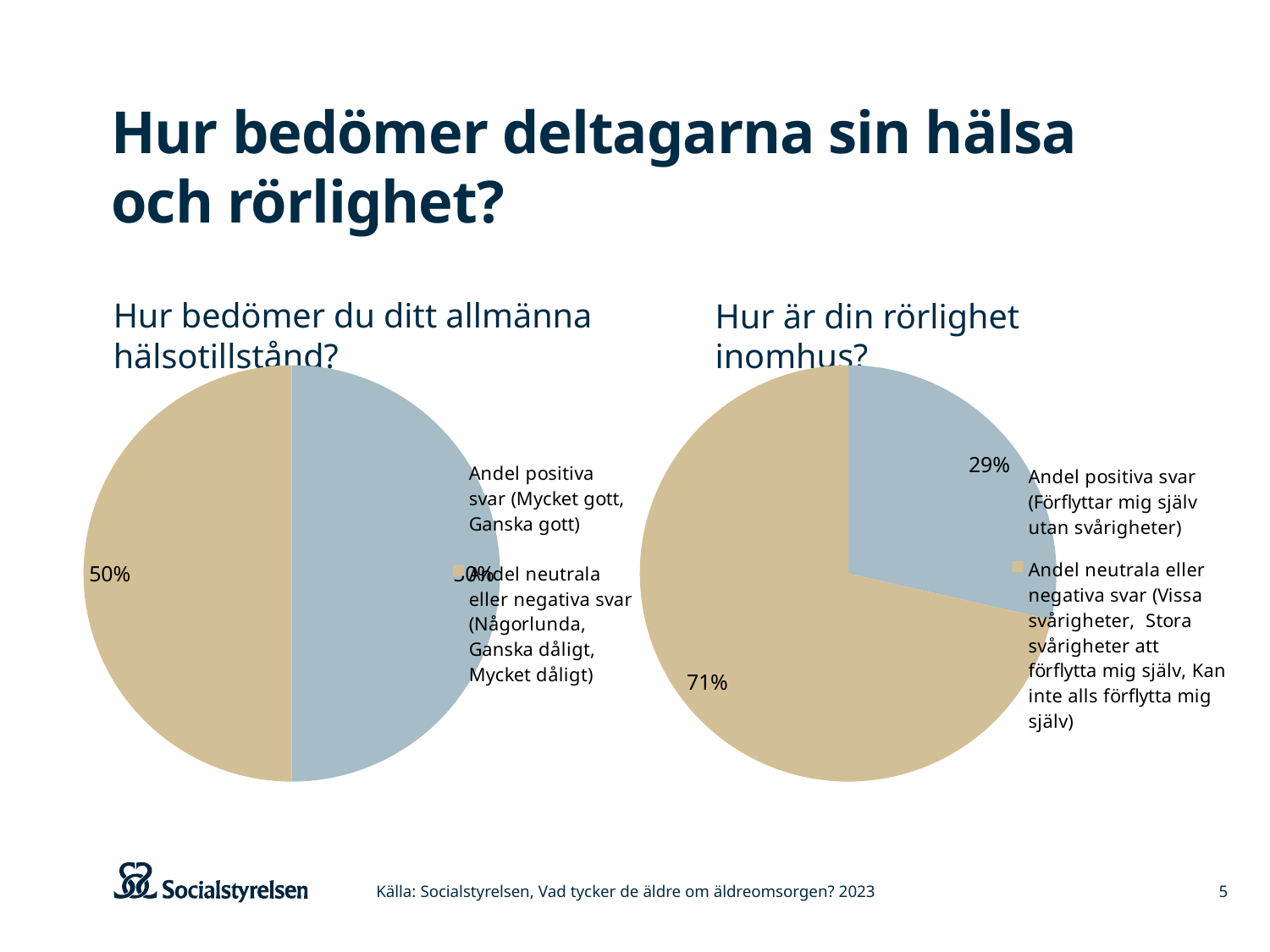
In the chart titled "Hur är din rörlighet inomhus?", which slice is the largest? Andel neutrala eller negativa svar In the chart titled "Hur är din rörlighet inomhus?", what share of the pie is "Andel neutrala eller negativa svar"? 71% What kind of chart is used for "Hur bedömer du ditt allmänna hälsotillstånd?"? pie chart In the chart titled "Hur är din rörlighet inomhus?", what colour is the slice for "Andel positiva svar"? blue-grey In the chart titled "Hur är din rörlighet inomhus?", what is the difference in percentage points between the neutral/negative slice and the positive slice? 42 percentage points In the chart titled "Hur är din rörlighet inomhus?", what share of the pie is "Andel positiva svar (Förflyttar mig själv utan svårigheter)"? 29% How many slices does the pie chart titled "Hur är din rörlighet inomhus?" have? 2 In the chart titled "Hur bedömer du ditt allmänna hälsotillstånd?", what share of the pie is "Andel neutrala eller negativa svar"? 50% How many entries does the legend of the chart titled "Hur är din rörlighet inomhus?" list? 2 In the chart titled "Hur är din rörlighet inomhus?", is the positive-answer slice larger or smaller than the neutral/negative slice? smaller In the chart titled "Hur är din rörlighet inomhus?", which slice is the smallest? Andel positiva svar How many pie charts are shown on the slide? 2